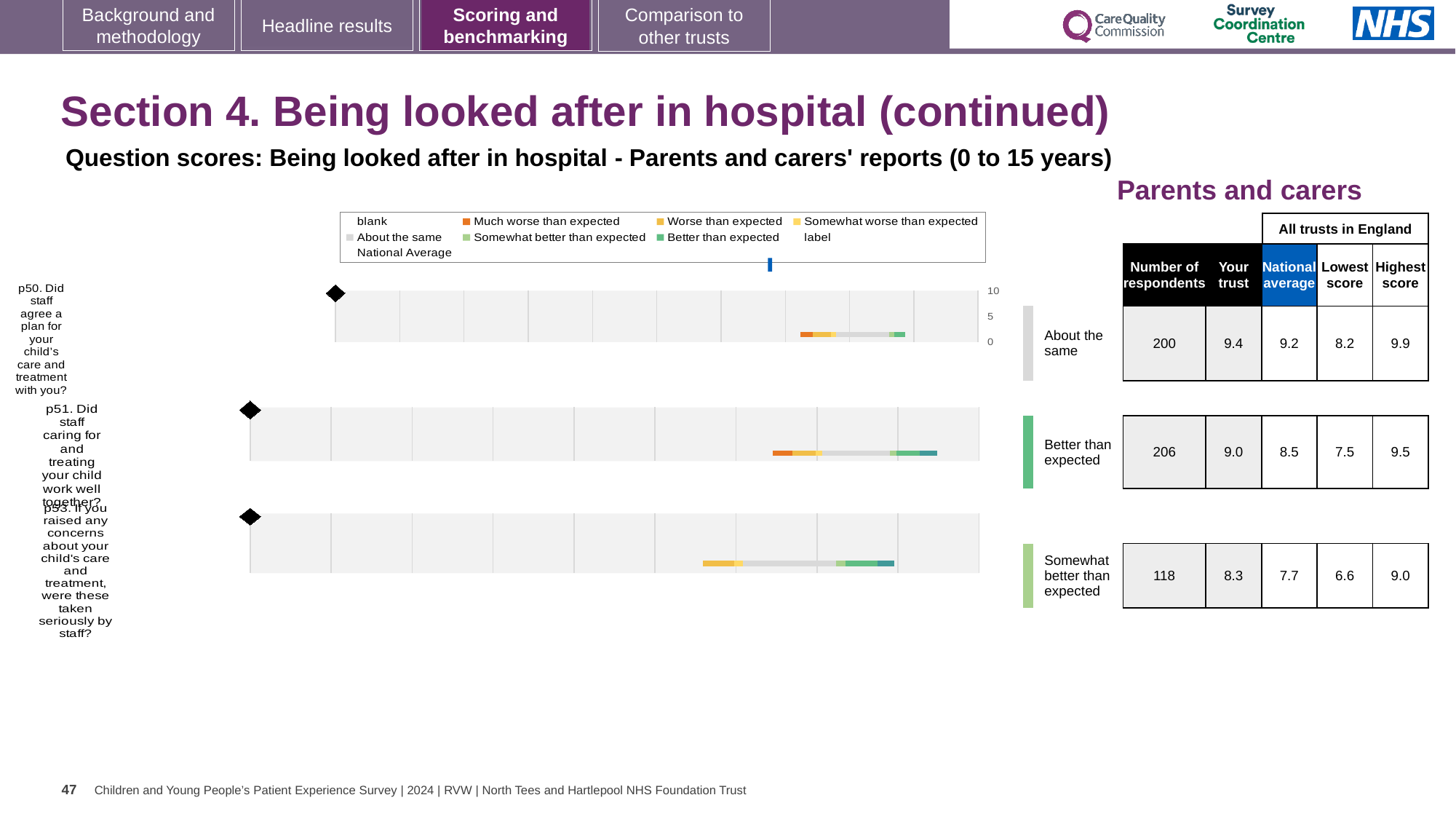
Which question has the fewest respondents? p53 What is the lowest score among all trusts in England for p53? 6.6 What kind of chart is used to show the question scores on this slide? bar chart What is the 'Your trust' score for p50 (Did staff agree a plan for your child's care and treatment with you)? 9.4 How many respondents answered p53 (If you raised any concerns about your child's care and treatment, were these taken seriously by staff)? 118 What benchmark category is shown for p51? Better than expected By how much does the trust's score for p51 exceed the national average for p51? 0.5 For p53, which is larger: the trust's score or the national average? Your trust Which question has the highest 'Your trust' score? p50 What is the highest score among all trusts in England for p50? 9.9 How many questions (p50, p51, p53) are plotted on the slide? 3 What is the national average score for p51 (Did staff caring for and treating your child work well together)? 8.5